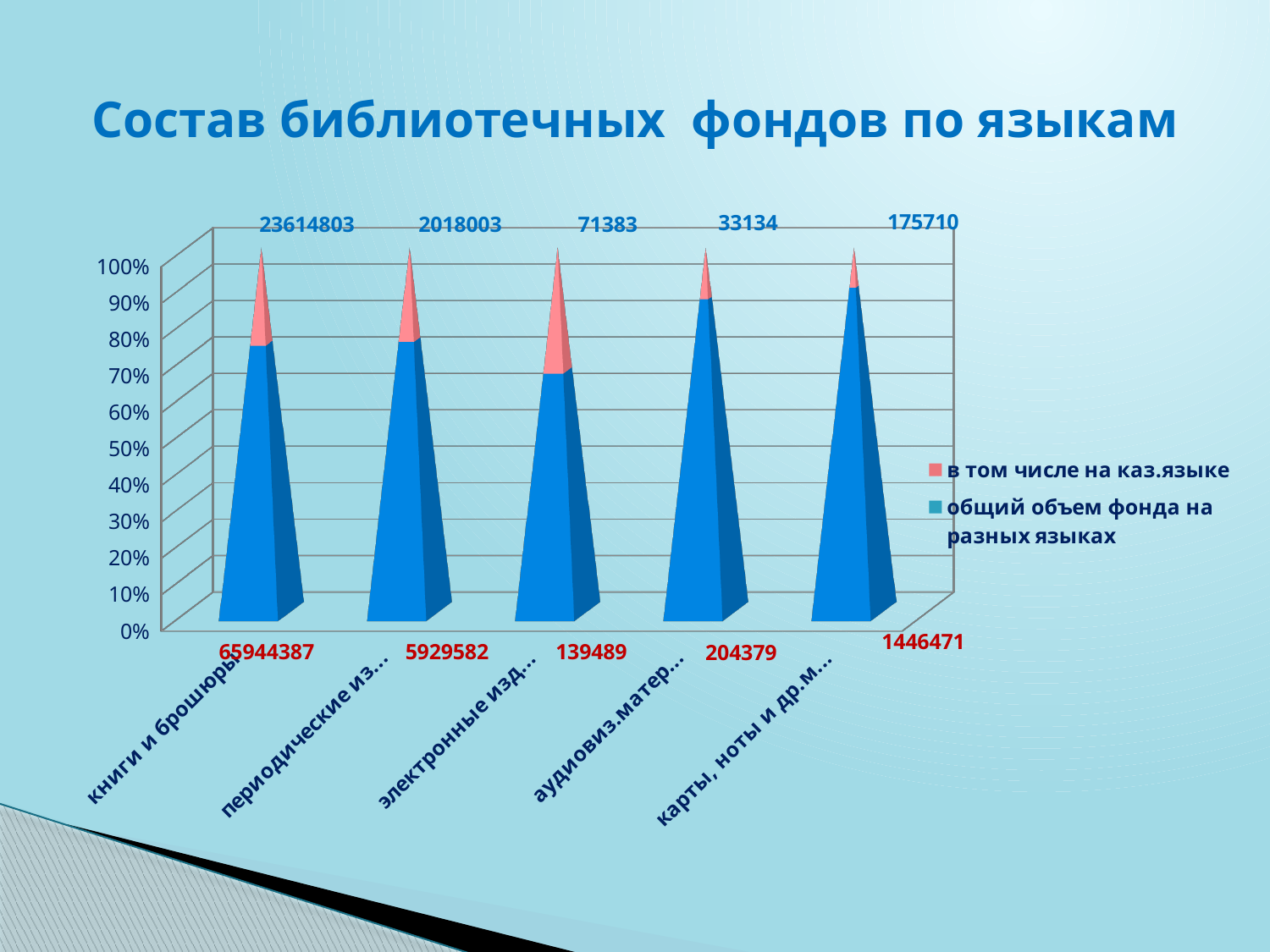
What kind of chart is shown on the slide? Stacked bar chart What is the title of the chart? Состав библиотечных фондов по языкам What is the value of "в том числе на каз.языке" for the last category (карты, ноты и др.м...)? 175710 How many series does the legend list? 2 What is the difference between "общий объем фонда на разных языках" and "в том числе на каз.языке" for "книги и брошюры"? 42329584 Which category has the lowest value for "в том числе на каз.языке"? аудиовиз.матер... (fourth category) Which is larger for "общий объем фонда на разных языках": the third category (электронные изд...) or the fourth category (аудиовиз.матер...)? аудиовиз.матер... (fourth category) What is the value of "в том числе на каз.языке" for "книги и брошюры"? 23614803 Which category has the highest value for "общий объем фонда на разных языках"? книги и брошюры How many categories are shown on the x axis? 5 What is the difference between "общий объем фонда на разных языках" and "в том числе на каз.языке" for the second category (периодические из...)? 3911579 What is the value of "общий объем фонда на разных языках" for "книги и брошюры"? 65944387